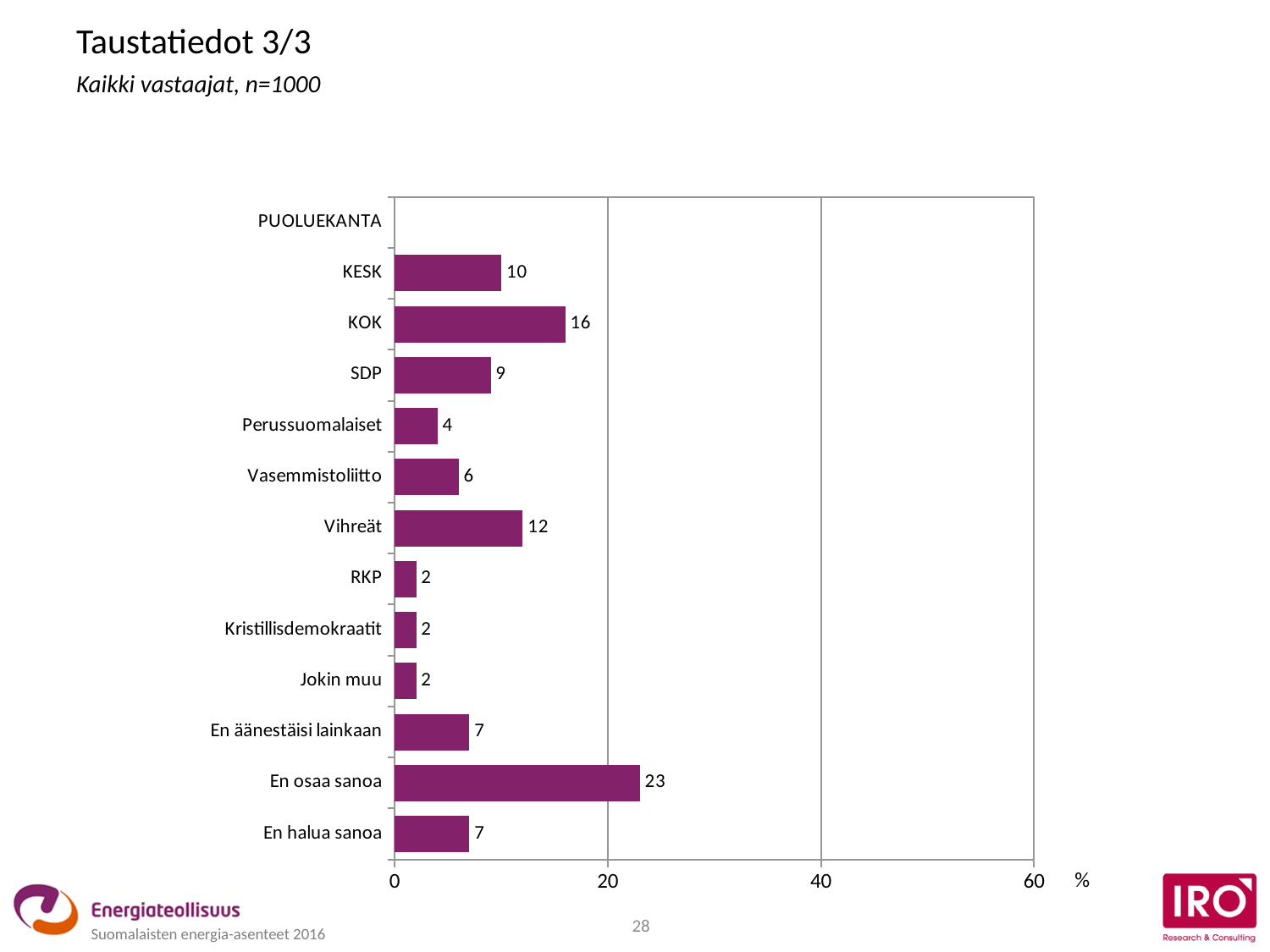
Which is larger, the value for SDP or the value for Vasemmistoliitto? SDP What is the value for Vihreät? 12 Is the value for En osaa sanoa greater or less than 20? greater How many bars are plotted on the chart? 12 Which category has the highest value? En osaa sanoa What is the value for En äänestäisi lainkaan? 7 What is the title of the slide? Taustatiedot 3/3 What is the difference between the values for KOK and KESK? 6 What is the value for KOK? 16 What is the difference between the values for En osaa sanoa and Vihreät? 11 What is the lowest value shown on the chart? 2 What kind of chart is shown on the slide? bar chart